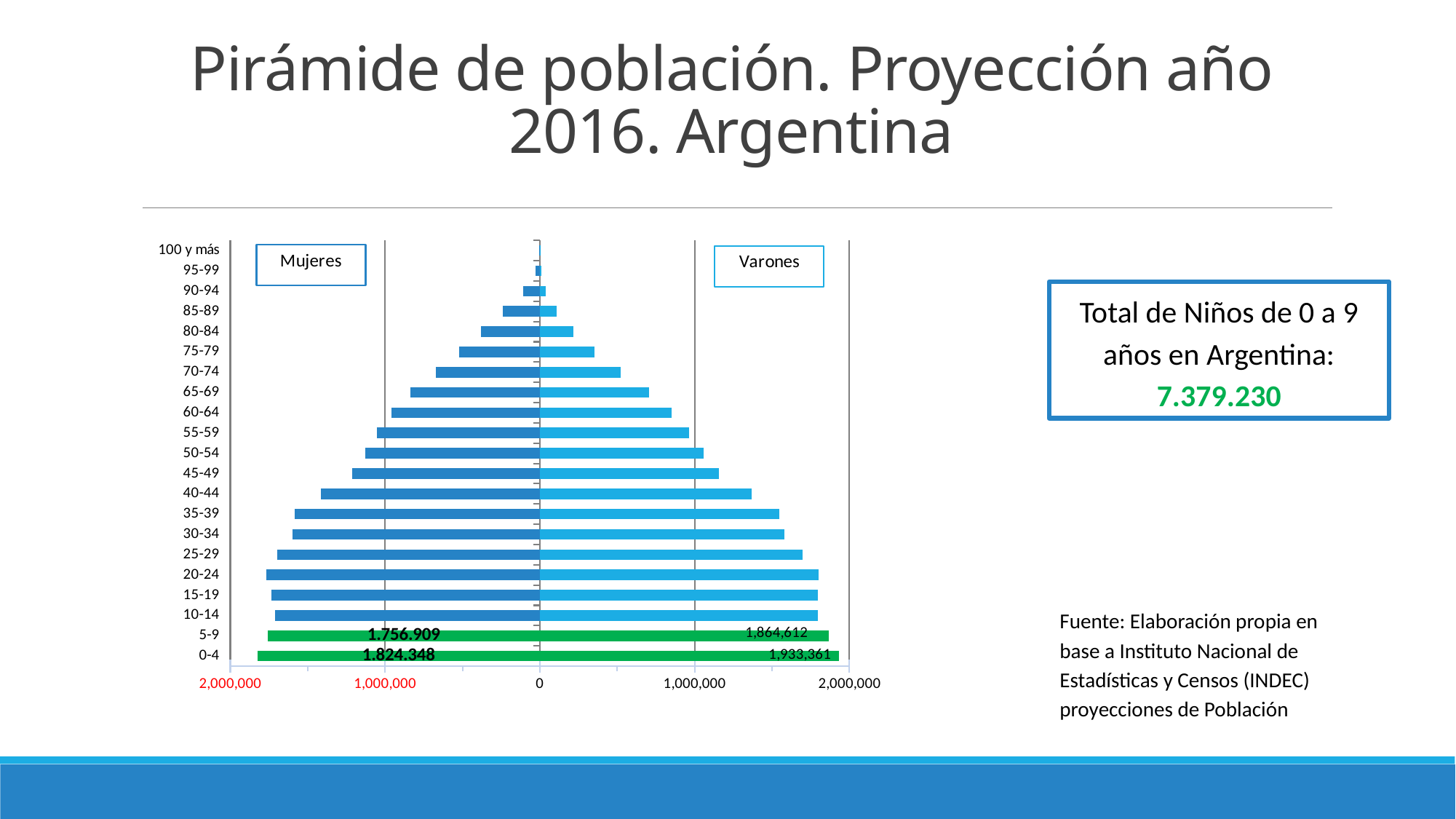
What is the value for Varones in the 0-4 age group? 1,933,361 What kind of chart is shown on the slide? Bar chart (population pyramid) How many age groups are shown on the chart? 21 Which is larger in the 0-4 age group, Mujeres or Varones? Varones Is the value for Varones in the 70-74 age group greater or less than 1,000,000? less Is the value for Mujeres in the 20-24 age group greater or less than 1,000,000? greater What is the value for Mujeres in the 0-4 age group? 1.824.348 Which age group has the highest value for Varones? 0-4 What is the value for Mujeres in the 5-9 age group? 1.756.909 What is the value for Varones in the 5-9 age group? 1,864,612 How many series does the chart show? 2 What is the difference between the Varones values for the 0-4 and 5-9 age groups? 68,749